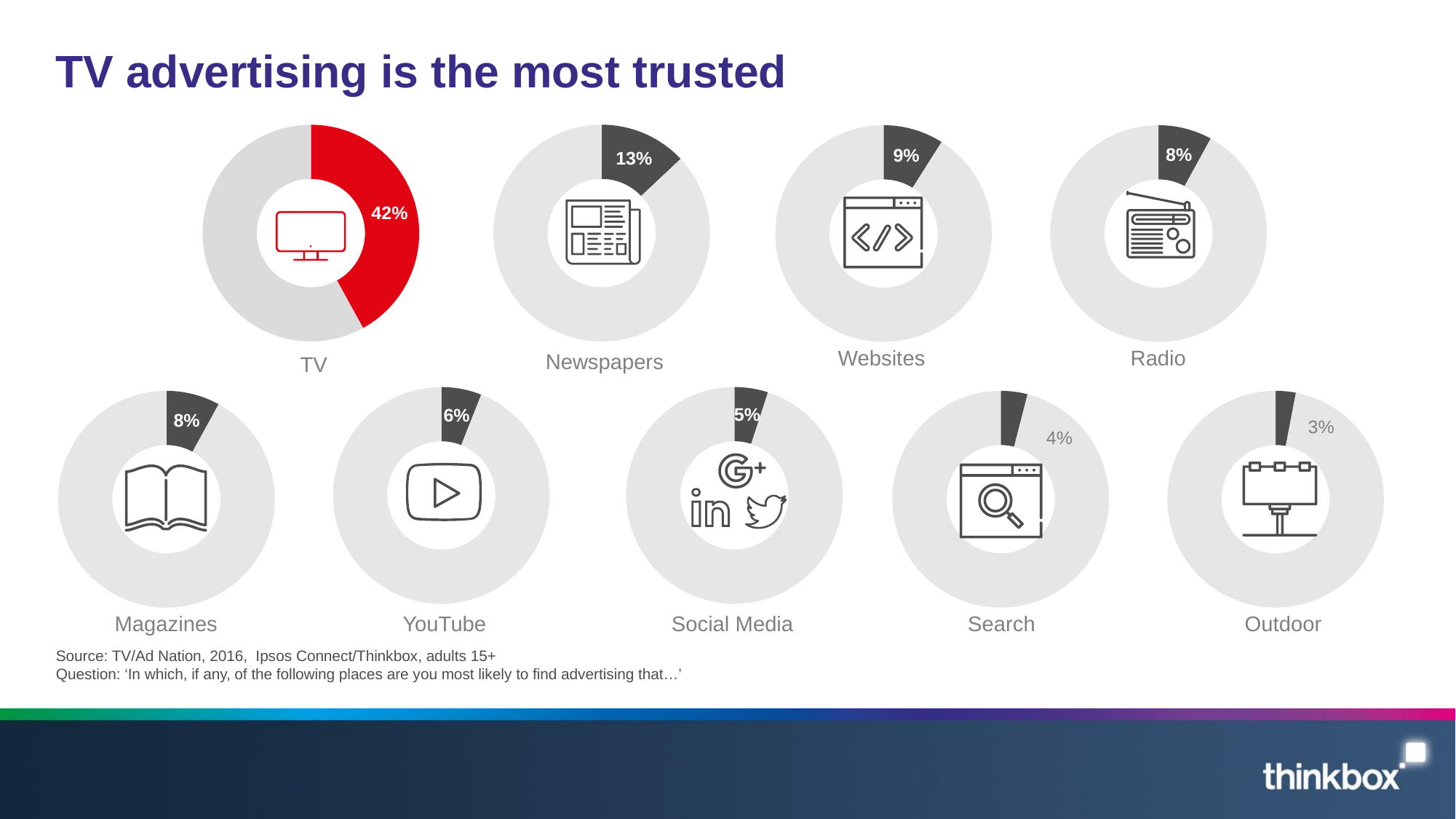
What percentage is shown for the Outdoor donut chart? 3% What kind of chart is used for each medium on the slide? Donut chart Which medium has the lowest percentage across the donut charts? Outdoor How many donut charts are shown on the slide? 9 What percentage is shown for the TV donut chart? 42% Which donut chart is highlighted in red rather than dark grey? TV Which medium has the highest percentage across the donut charts? TV What percentage is shown for the Websites donut chart? 9% Which two media both show 8%? Radio and Magazines What is the difference between the TV percentage and the Newspapers percentage? 29% Which has a larger percentage, YouTube or Social Media? YouTube What percentage is shown for the Newspapers donut chart? 13%